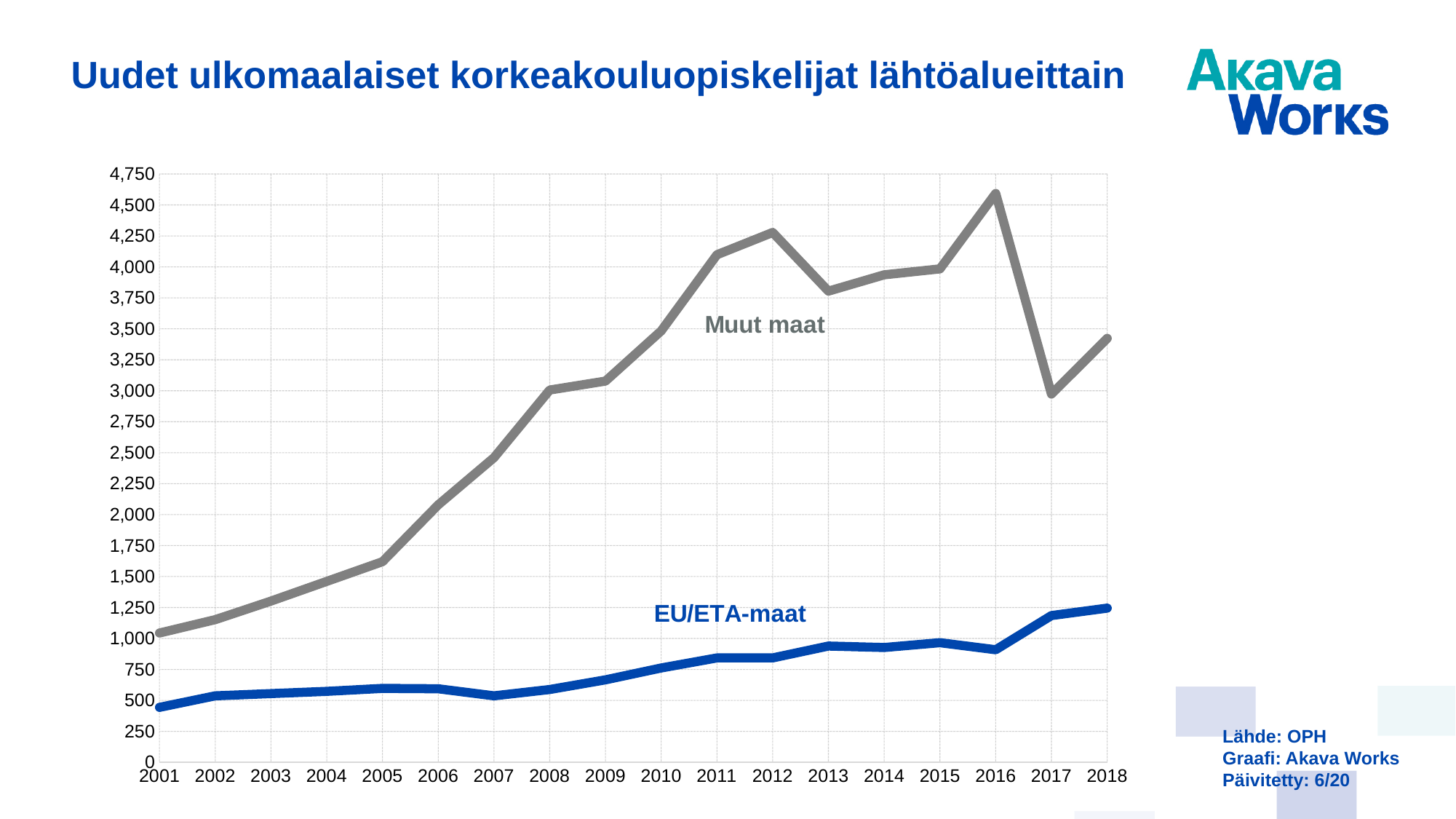
In which year is the EU/ETA-maat series at its lowest value? 2001 In which year is the Muut maat series at its lowest value? 2001 How many years are plotted along the x axis? 18 Which series has the larger value in 2010, Muut maat or EU/ETA-maat? Muut maat How many data series are plotted on the chart? 2 Does the Muut maat series rise or fall between 2016 and 2017? fall Is the value for Muut maat in 2005 greater or less than 1,500? greater Is the value for EU/ETA-maat in 2018 greater or less than 1,000? greater What kind of chart is shown on the slide? line chart In which year does the Muut maat series reach its highest value? 2016 Is the value for EU/ETA-maat in 2013 greater or less than 1,000? less What is the title of the chart? Uudet ulkomaalaiset korkeakouluopiskelijat lähtöalueittain